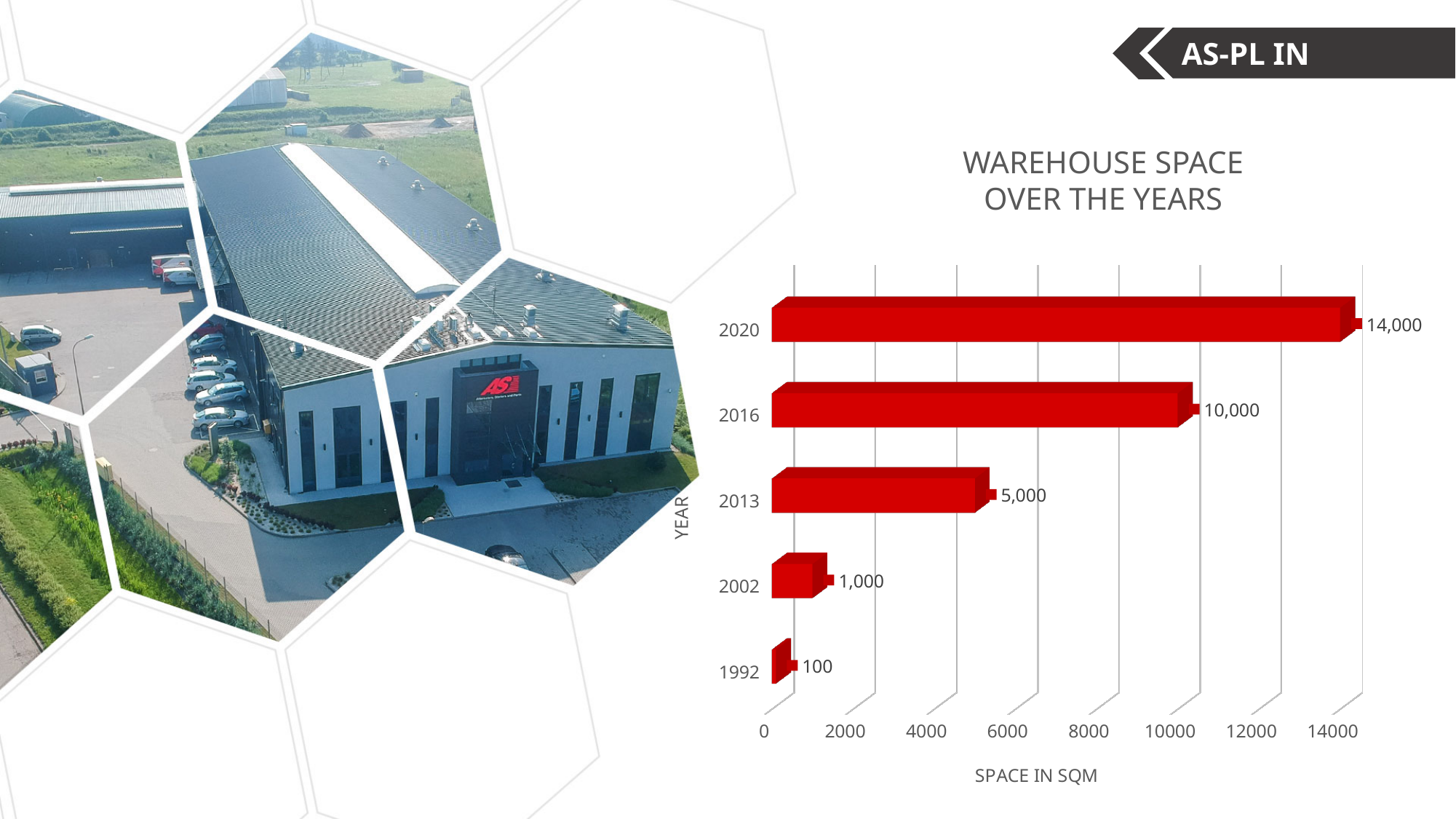
Is the warehouse space for 2016 greater or less than 8000? greater What is the title of the chart? WAREHOUSE SPACE OVER THE YEARS What is the warehouse space in 2020? 14,000 What is the difference in warehouse space between 2013 and 2002? 4,000 Which year has the smallest warehouse space? 1992 How many years are shown in the chart? 5 Which year has more warehouse space, 2002 or 2013? 2013 What is the warehouse space in 1992? 100 Which year has the largest warehouse space? 2020 What is the warehouse space in 2013? 5,000 What type of chart is used to show warehouse space over the years? Bar chart What is the difference in warehouse space between 2020 and 2016? 4,000